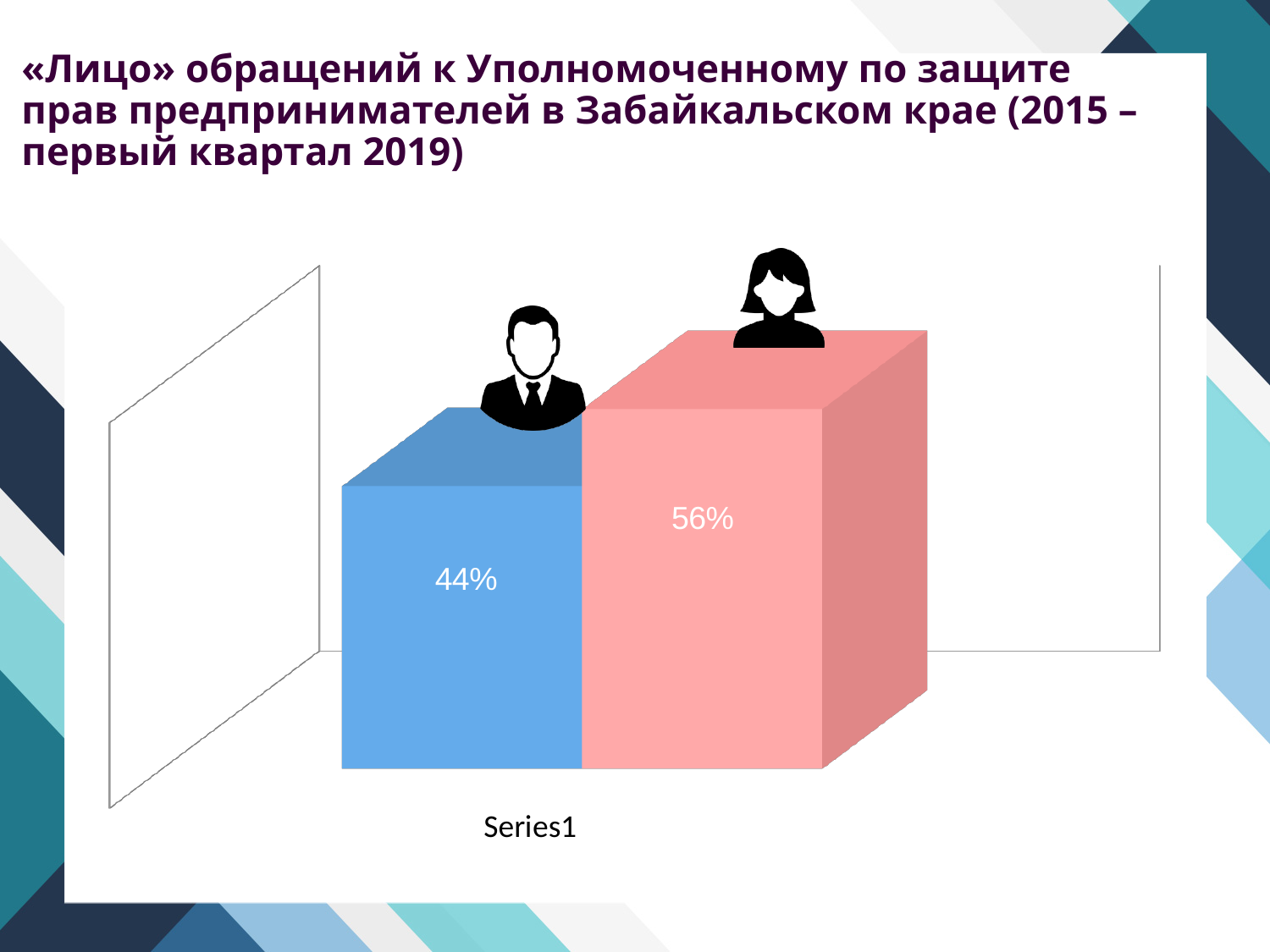
How many bars are plotted in the chart? 2 Which bar shows the highest value, the blue one or the pink one? the pink bar (56%) What value is printed on the pink bar (with the female icon)? 56% Which bar shows the lowest value, the blue one or the pink one? the blue bar (44%) What kind of chart is shown on the slide? bar chart Is the value on the bar with the female icon larger or smaller than the value on the bar with the male icon? larger What is the difference between the value on the pink bar and the value on the blue bar? 12 percentage points What do the two percentages printed on the bars add up to? 100% What label is shown on the category axis below the bars? Series1 What value is printed on the blue bar (with the male icon)? 44% What colour is the bar that carries the 56% label? pink